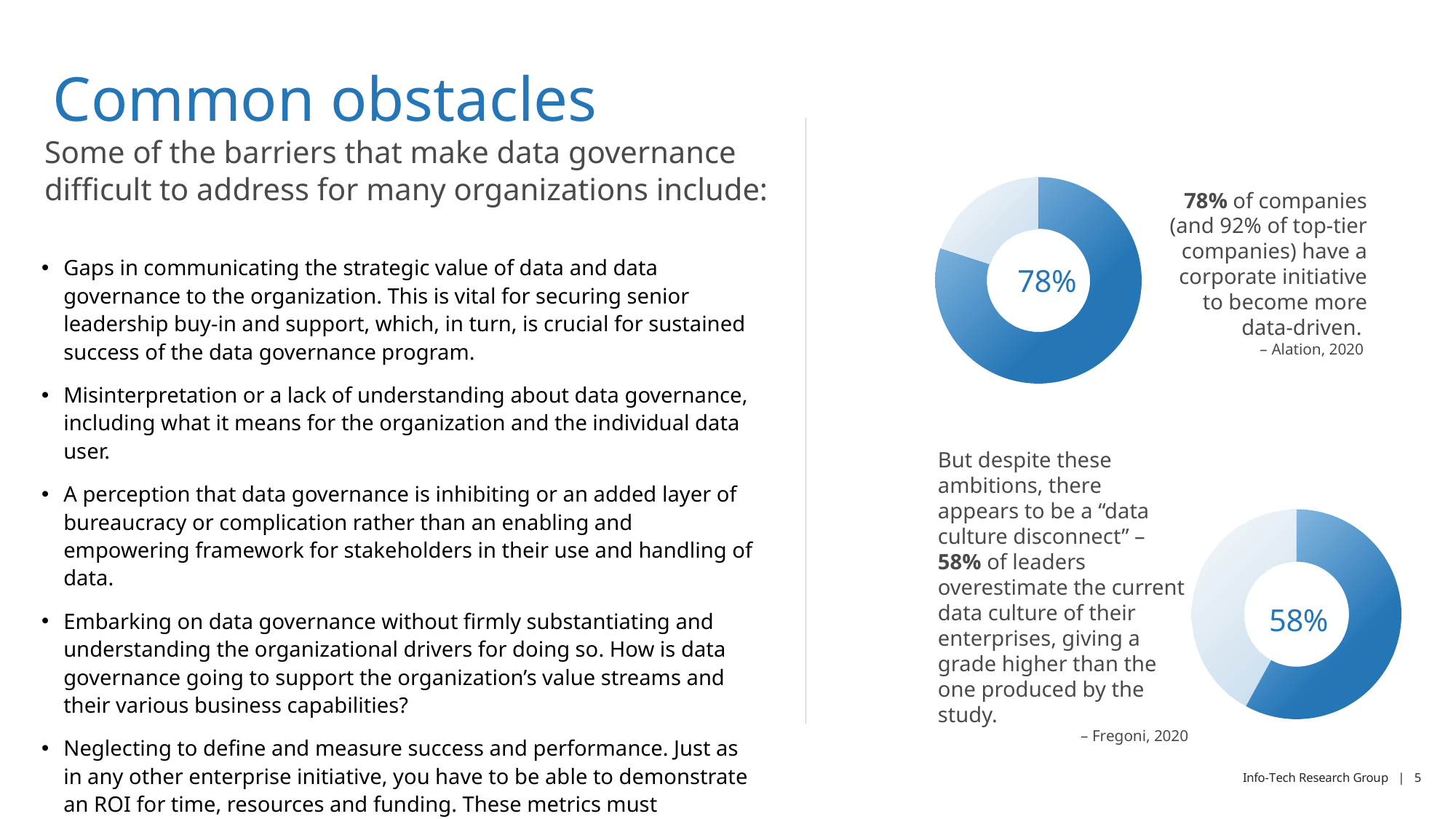
How many slices does each donut chart have? 2 Which donut chart shows the larger percentage, the top one or the bottom one? The top one (78%) In the bottom-right donut chart, what share of the ring does the dark blue slice represent? 58% What source is cited next to the bottom-right donut chart? Fregoni, 2020 What source is cited next to the top-right donut chart? Alation, 2020 What kind of chart is shown at the top right of the slide? Donut (pie) chart How many donut charts are on the slide? 2 In the bottom-right donut chart, what percentage is printed in the centre? 58% What is the difference between the percentage in the top donut chart and the percentage in the bottom donut chart? 20 percentage points In the top-right donut chart, what percentage is printed in the centre? 78% In the bottom-right donut chart, is the dark blue slice larger or smaller than the light slice? Larger